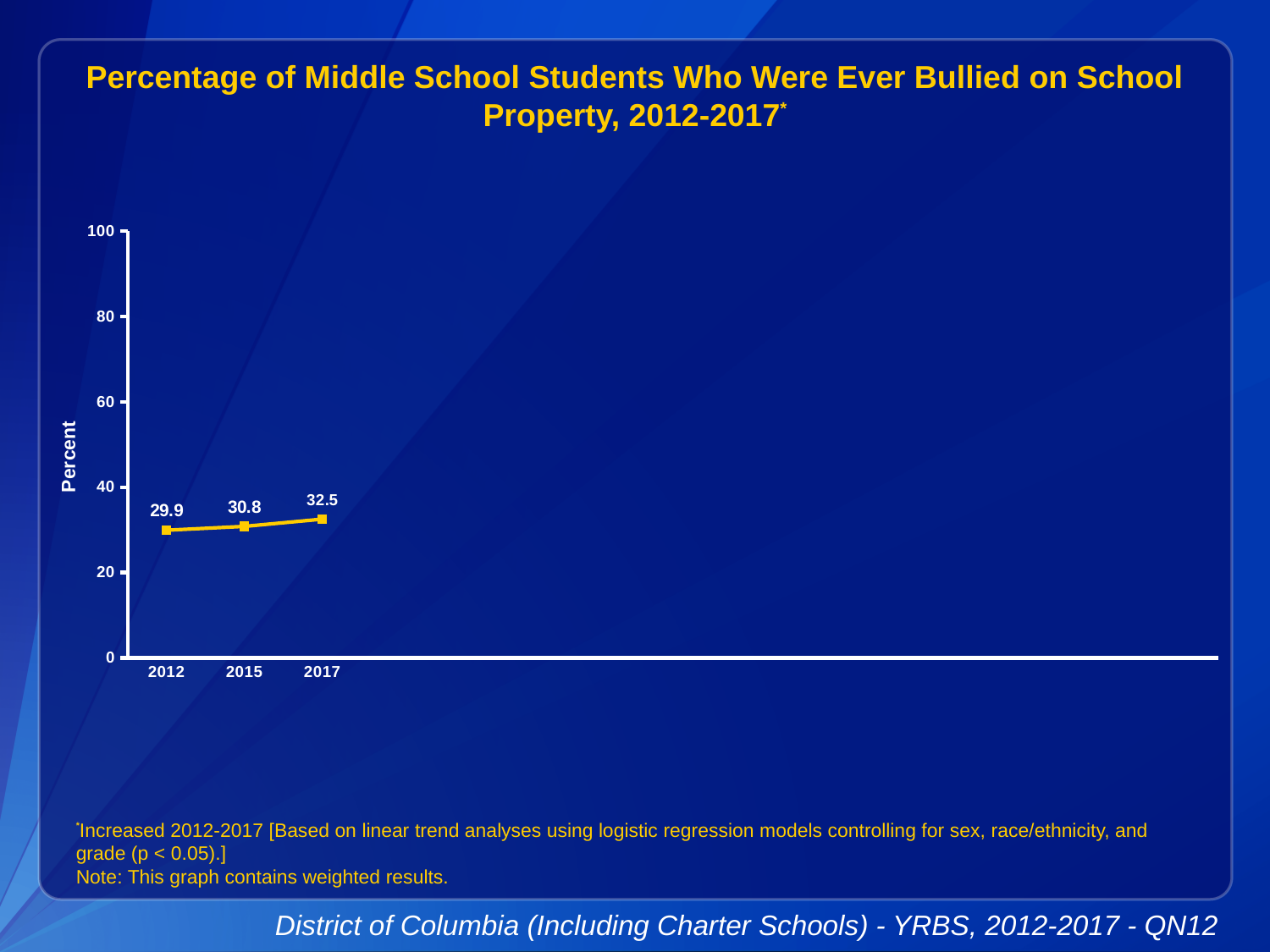
In which year was the percentage of students bullied on school property lowest? 2012 What is the label on the y axis of the chart? Percent What was the percentage of middle school students who were ever bullied on school property in 2017? 32.5 What was the percentage of middle school students who were ever bullied on school property in 2012? 29.9 In which year was the percentage of students bullied on school property highest? 2017 How many years are plotted on the chart? 3 Which year had a higher value, 2015 or 2017? 2017 What kind of chart is shown on the slide? line chart Do the values rise or fall from 2012 to 2017? rise What was the percentage of middle school students who were ever bullied on school property in 2015? 30.8 What is the difference between the 2017 and 2012 values? 2.6 Is the value for 2017 greater or less than 40? less